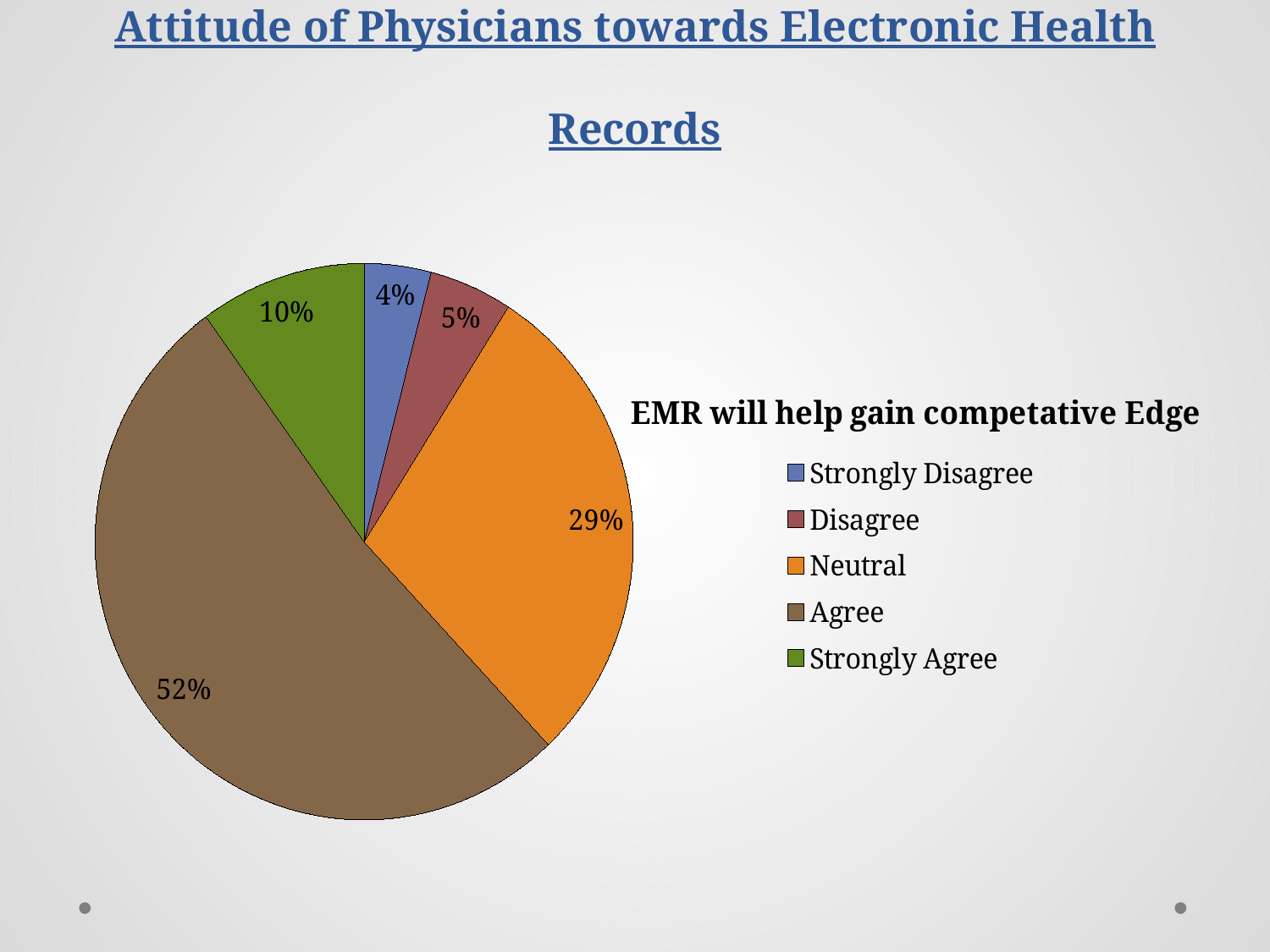
What kind of chart is shown on the slide? pie chart Which is larger, the share for Strongly Agree or the share for Disagree? Strongly Agree What percentage of physicians chose Strongly Disagree? 4% What is the title of the chart? EMR will help gain competative Edge What percentage of physicians chose Agree? 52% How many categories does the legend list? 5 Which response has the largest share of the pie? Agree What percentage of physicians chose Disagree? 5% What percentage of physicians chose Strongly Agree? 10% Which response has the smallest share of the pie? Strongly Disagree What percentage of physicians chose Neutral? 29% What is the difference in percentage points between Agree and Neutral? 23